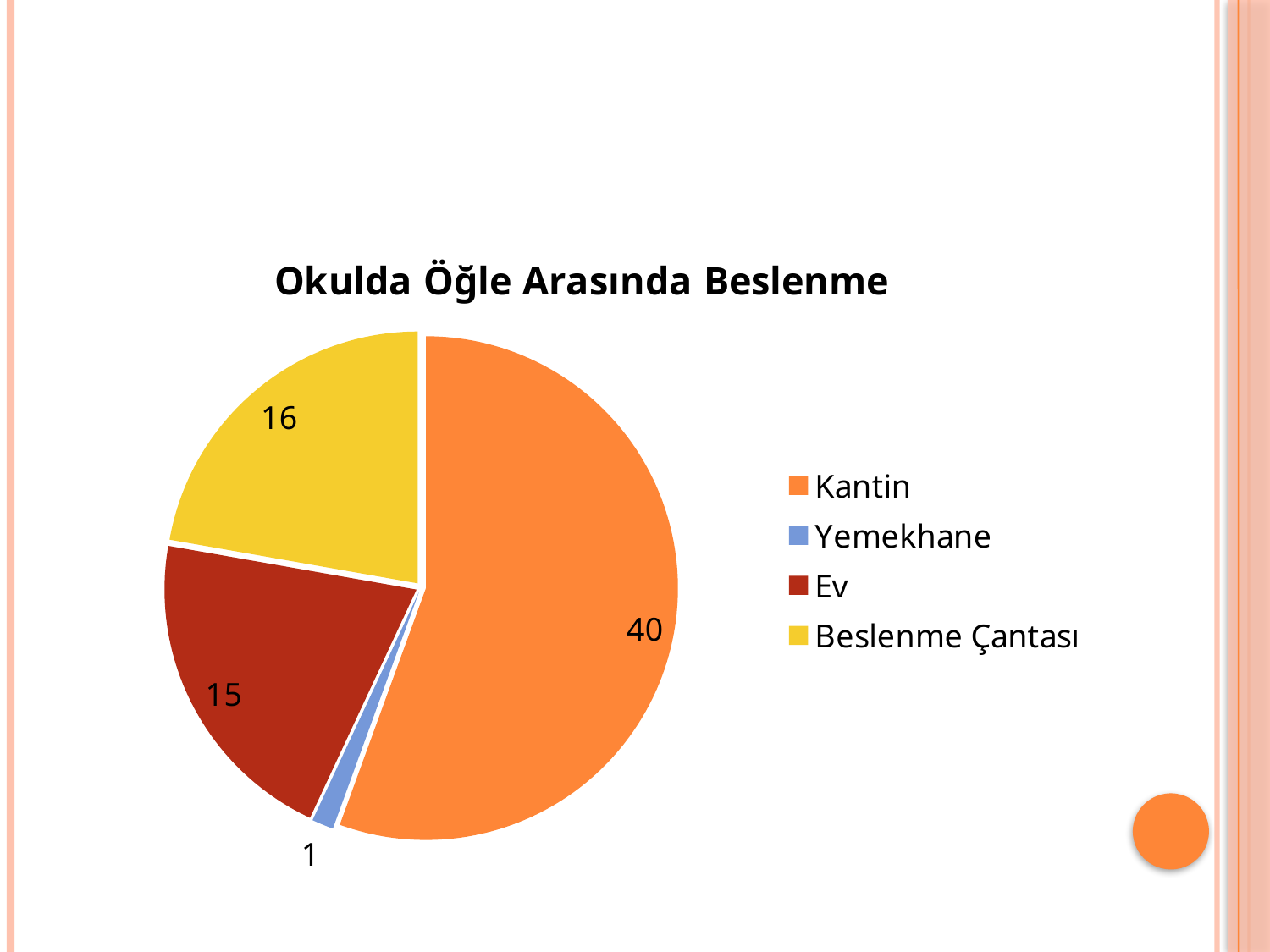
What is the value for Yemekhane? 1 What is the title of the chart? Okulda Öğle Arasında Beslenme How many categories does the pie chart show? 4 Which is larger, Ev or Beslenme Çantası? Beslenme Çantası What kind of chart is shown on the slide? Pie chart What is the value for Beslenme Çantası? 16 What is the difference between the values for Kantin and Beslenme Çantası? 24 What is the sum of all the slice values in the pie chart? 72 Which category has the smallest slice? Yemekhane What is the value for Ev? 15 Which category has the largest slice? Kantin What is the value for Kantin? 40